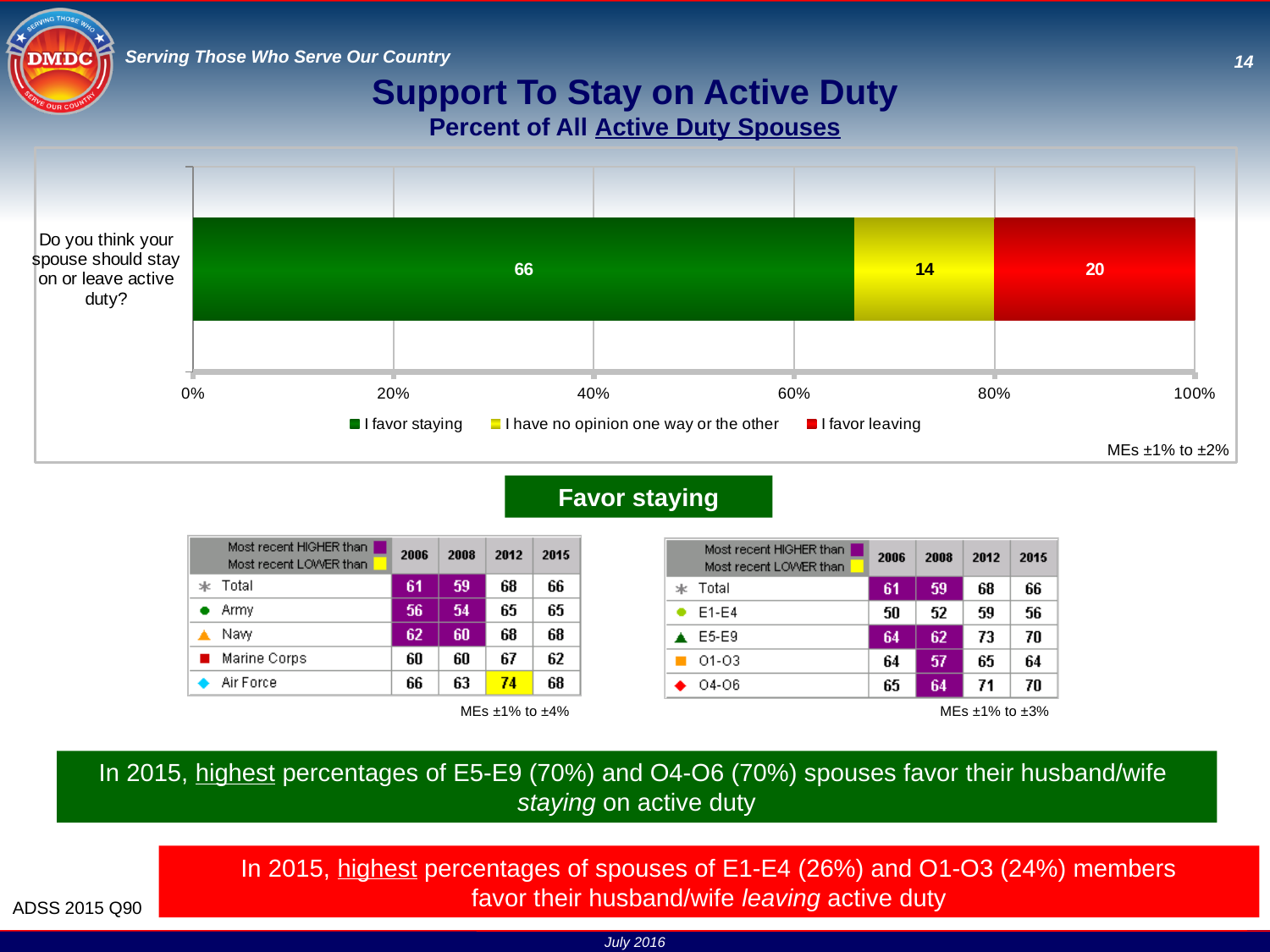
Is the value for "I favor staying" greater or less than 60%? greater Which response has the largest segment in the stacked bar? I favor staying What percentage of active duty spouses answered "I favor staying"? 66 What colour represents "I favor staying" in the chart? Green How many series does the chart legend list? 3 What is the total of the three segments in the stacked bar? 100 How many percentage points higher is "I favor staying" than "I favor leaving"? 46 What percentage of active duty spouses answered "I favor leaving"? 20 Which is larger, "I favor leaving" or "I have no opinion one way or the other"? I favor leaving What kind of chart is shown on the slide? Stacked bar chart Which response has the smallest segment in the stacked bar? I have no opinion one way or the other What percentage of active duty spouses answered "I have no opinion one way or the other"? 14